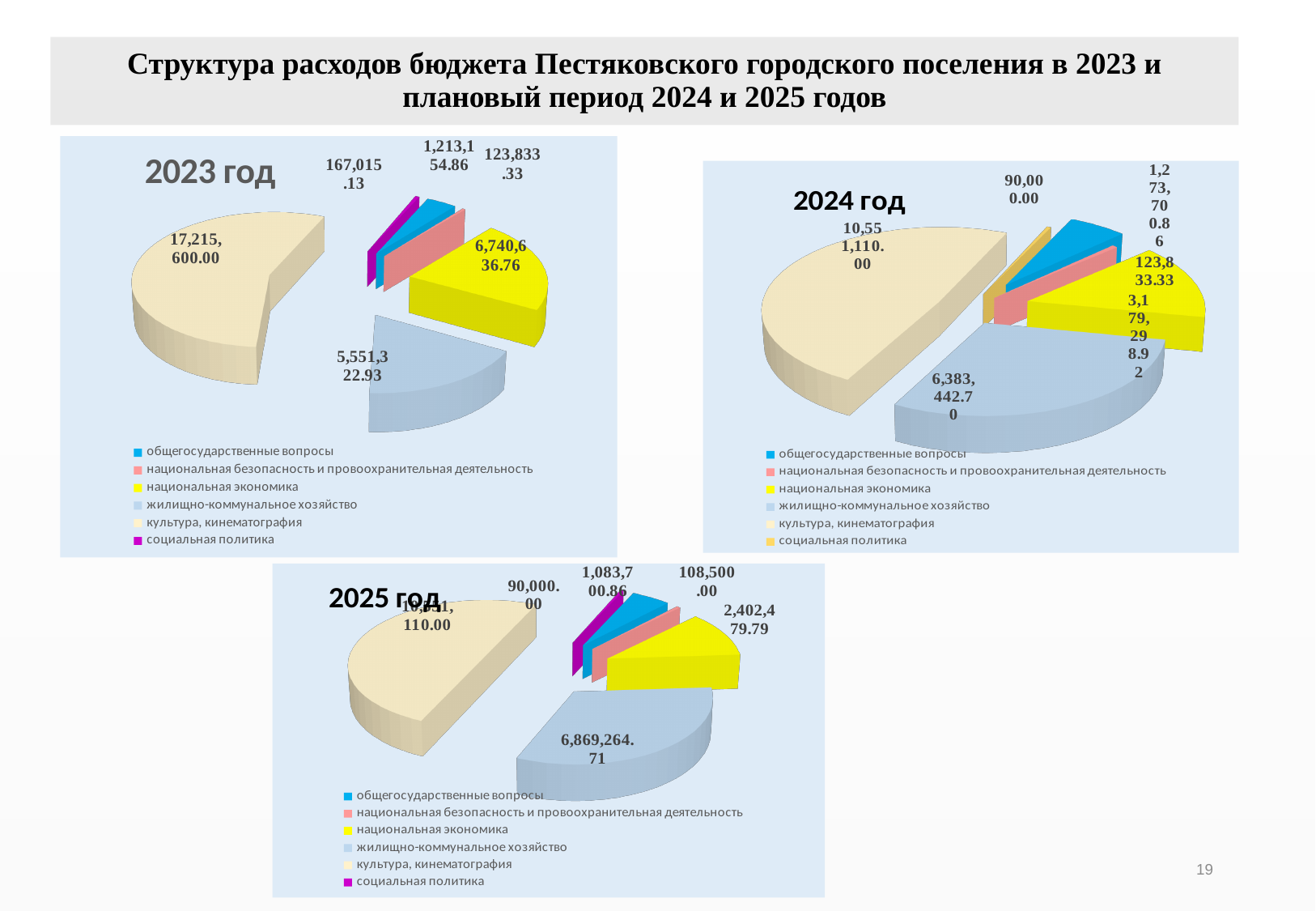
In the 2023 год chart, what is the value for культура, кинематография? 17,215,600.00 What kind of chart is used for the 2023 год chart? pie chart In the 2025 год chart, which is larger: жилищно-коммунальное хозяйство or национальная экономика? жилищно-коммунальное хозяйство In the 2024 год chart, what is the value for социальная политика? 90,000.00 In the 2025 год chart, what is the value for национальная безопасность и провоохранительная деятельность? 108,500.00 In the 2023 год chart, what is the value for национальная экономика? 6,740,636.76 In the 2024 год chart, which category has the smallest slice? социальная политика In the 2023 год chart, what is the difference between культура, кинематография and жилищно-коммунальное хозяйство? 11,664,277.07 In the 2023 год chart, which category has the largest slice? культура, кинематография How many categories does the legend of the 2024 год chart list? 6 In the 2025 год chart, what is the value for общегосударственные вопросы? 1,083,700.86 In the 2024 год chart, what is the value for жилищно-коммунальное хозяйство? 6,383,442.70